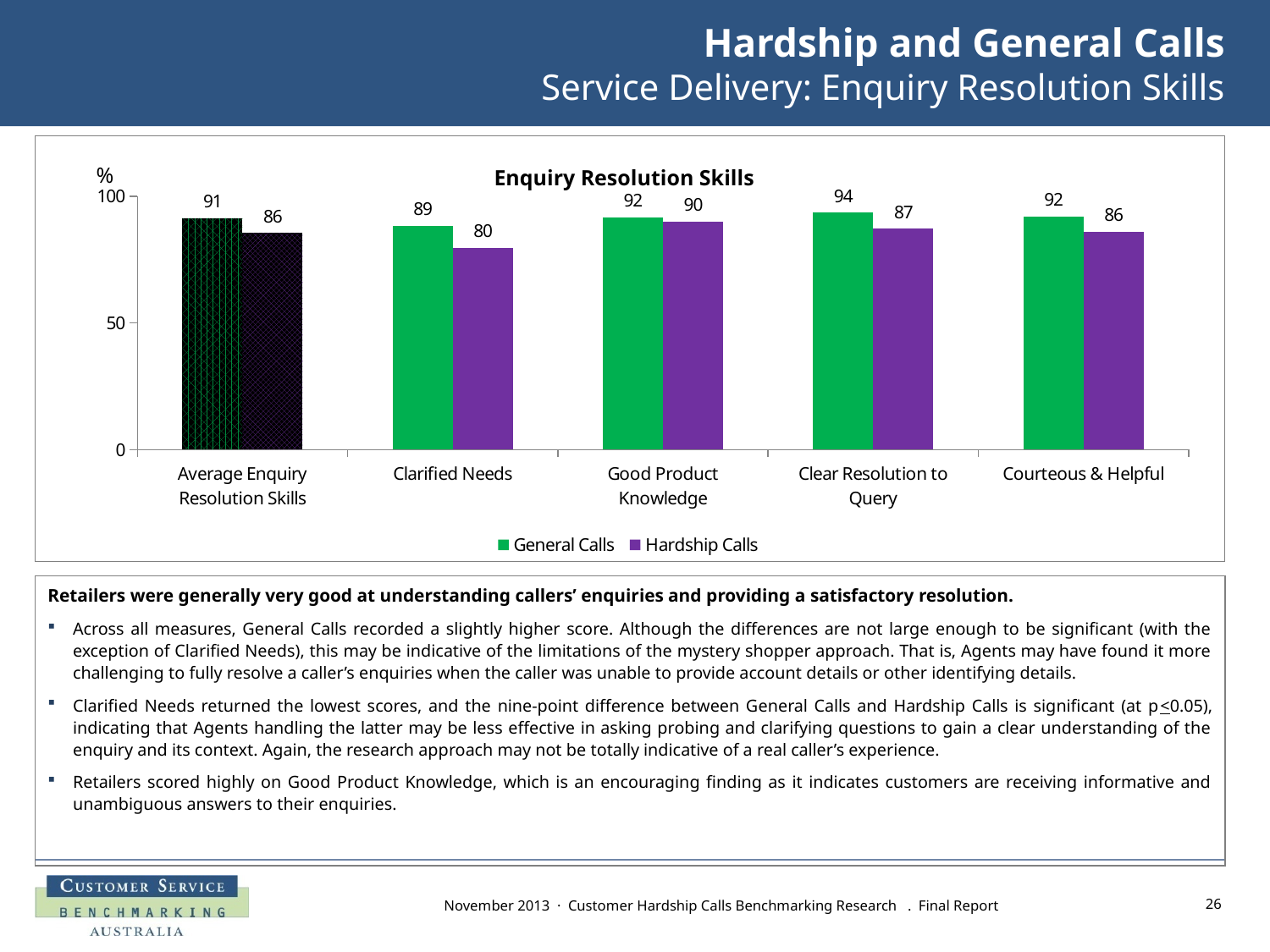
Which category has the highest General Calls value? Clear Resolution to Query Which colour represents Hardship Calls in the legend? purple What is the Hardship Calls value for Average Enquiry Resolution Skills? 86 How many categories are shown on the x axis? 5 What is the title of the chart? Enquiry Resolution Skills Which is larger for Good Product Knowledge: General Calls or Hardship Calls? General Calls What kind of chart is shown? bar chart What is the General Calls value for Clarified Needs? 89 What is the Hardship Calls value for Clear Resolution to Query? 87 Which category has the lowest Hardship Calls value? Clarified Needs How many series does the legend list? 2 What is the difference between the General Calls and Hardship Calls values for Clarified Needs? 9